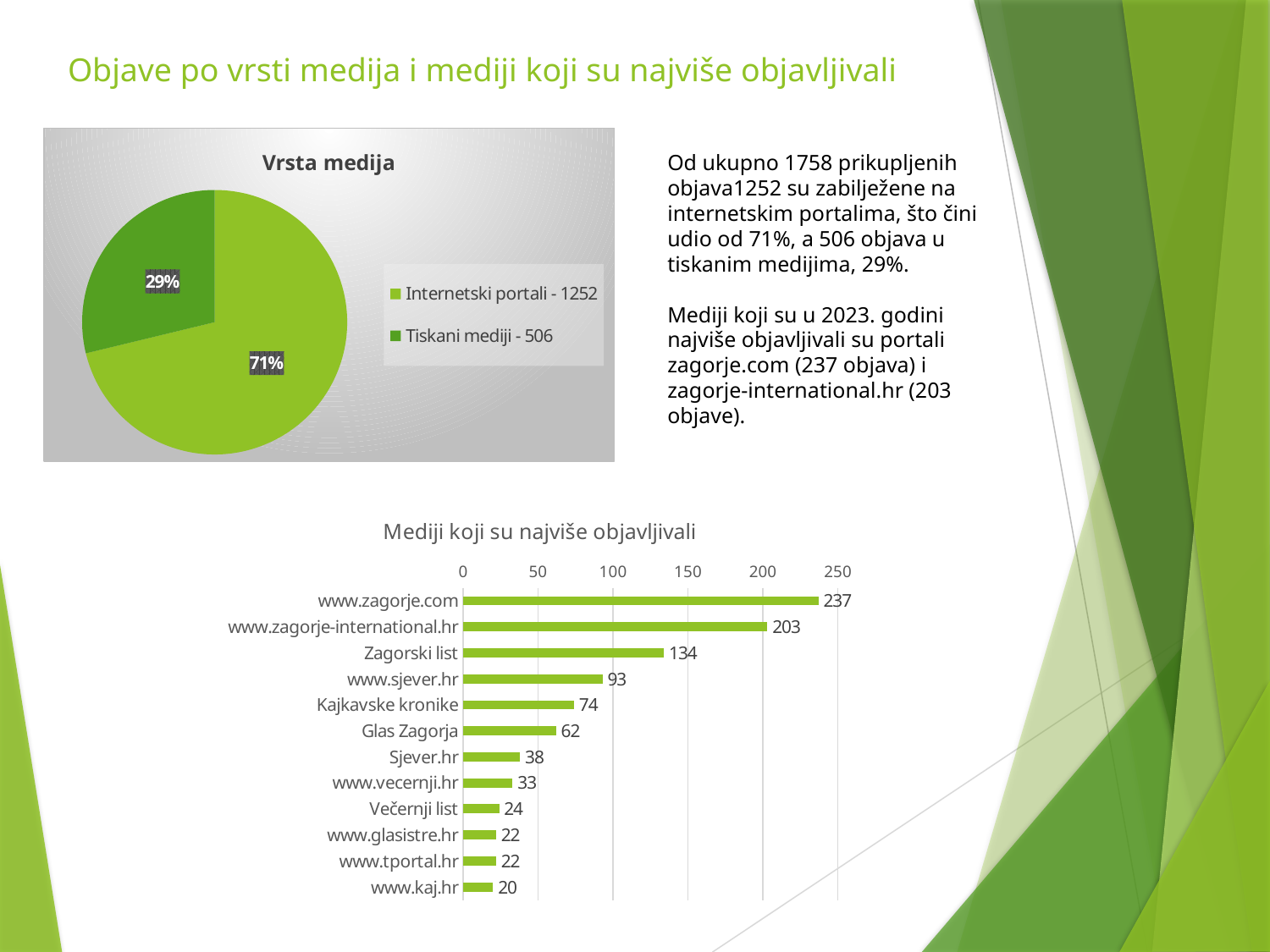
In the "Mediji koji su najviše objavljivali" chart, which category has the lowest value? www.kaj.hr How many entries does the legend of the "Vrsta medija" chart list? 2 In the "Mediji koji su najviše objavljivali" chart, what is the difference between www.zagorje.com and www.zagorje-international.hr? 34 How many categories are shown in the "Mediji koji su najviše objavljivali" chart? 12 In the "Vrsta medija" pie chart, what share is shown for Internetski portali? 71% What kind of chart is "Vrsta medija"? Pie chart In the "Mediji koji su najviše objavljivali" chart, what is the value for www.zagorje.com? 237 In the "Mediji koji su najviše objavljivali" chart, what is the value for Zagorski list? 134 In the "Mediji koji su najviše objavljivali" chart, which category has the highest value? www.zagorje.com In the "Mediji koji su najviše objavljivali" chart, which is larger: Kajkavske kronike or Glas Zagorja? Kajkavske kronike In the "Vrsta medija" pie chart, what share is shown for Tiskani mediji? 29% What kind of chart is "Mediji koji su najviše objavljivali"? Bar chart